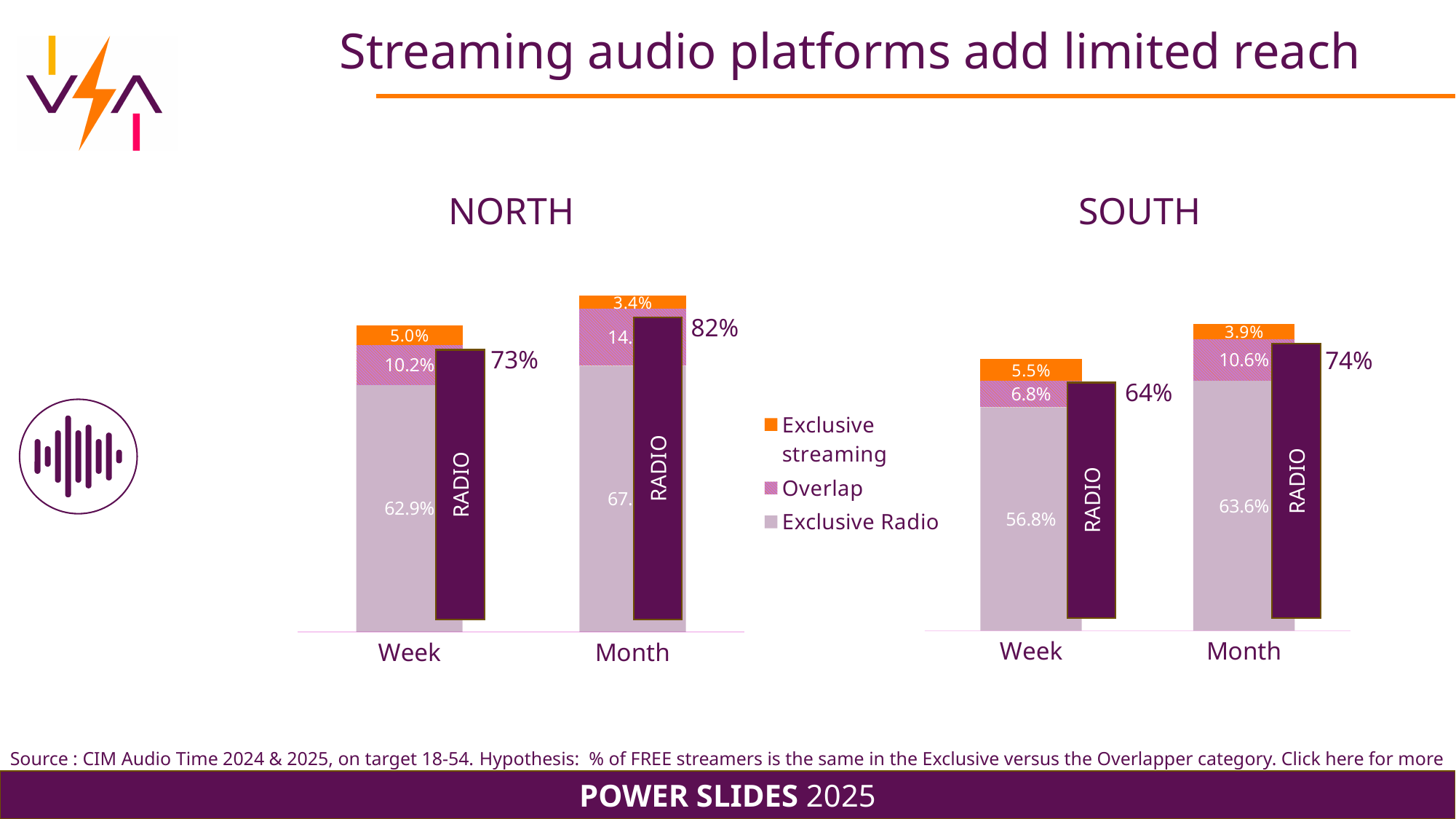
In the NORTH chart, what is the Exclusive streaming value for Month? 3.4% In the NORTH chart, what is the Exclusive streaming value for Week? 5.0% How many series does the legend list? 3 In the NORTH chart, which category has the higher Exclusive streaming value, Week or Month? Week In the SOUTH chart, what is the Exclusive streaming value for Month? 3.9% What kind of chart is the NORTH chart? Stacked bar chart In the SOUTH chart, what RADIO reach percentage is shown next to the Month bar? 74% In the SOUTH chart, what is the total of the stacked bar for Week? 69.1% In the SOUTH chart, what is the Exclusive Radio value for Month? 63.6% In the SOUTH chart, what is the difference between the Exclusive Radio values for Month and Week? 6.8% In the NORTH chart, what is the Exclusive Radio value for Week? 62.9% In the SOUTH chart, what is the Overlap value for Week? 6.8%